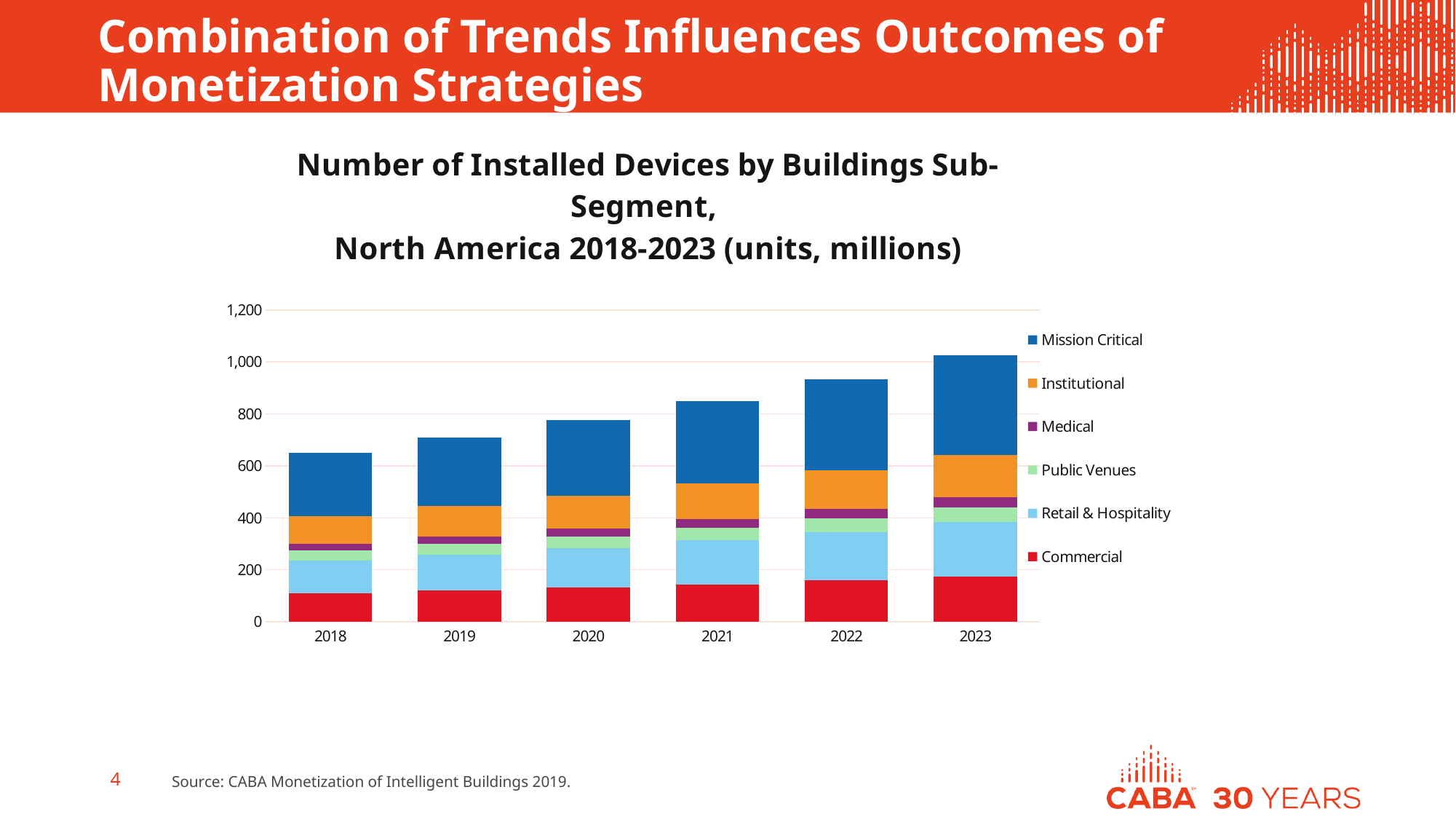
Which year has the shortest stacked bar in the chart? 2018 How many series does the chart's legend list? 6 Which year has the tallest stacked bar in the chart? 2023 Which is larger, the total stacked bar for 2021 or for 2019? 2021 How many years are shown on the x axis of the chart? 6 Is the total stacked bar for 2018 greater or less than 600? greater Which series forms the largest segment of the 2023 bar? Mission Critical Which series is shown at the bottom of each stacked bar? Commercial Is the Commercial segment for 2018 greater or less than 200? less Do the total installed devices rise or fall from 2018 to 2023? Rise Is the total stacked bar for 2022 greater or less than 1,000? less What kind of chart is shown on the slide? Stacked bar chart